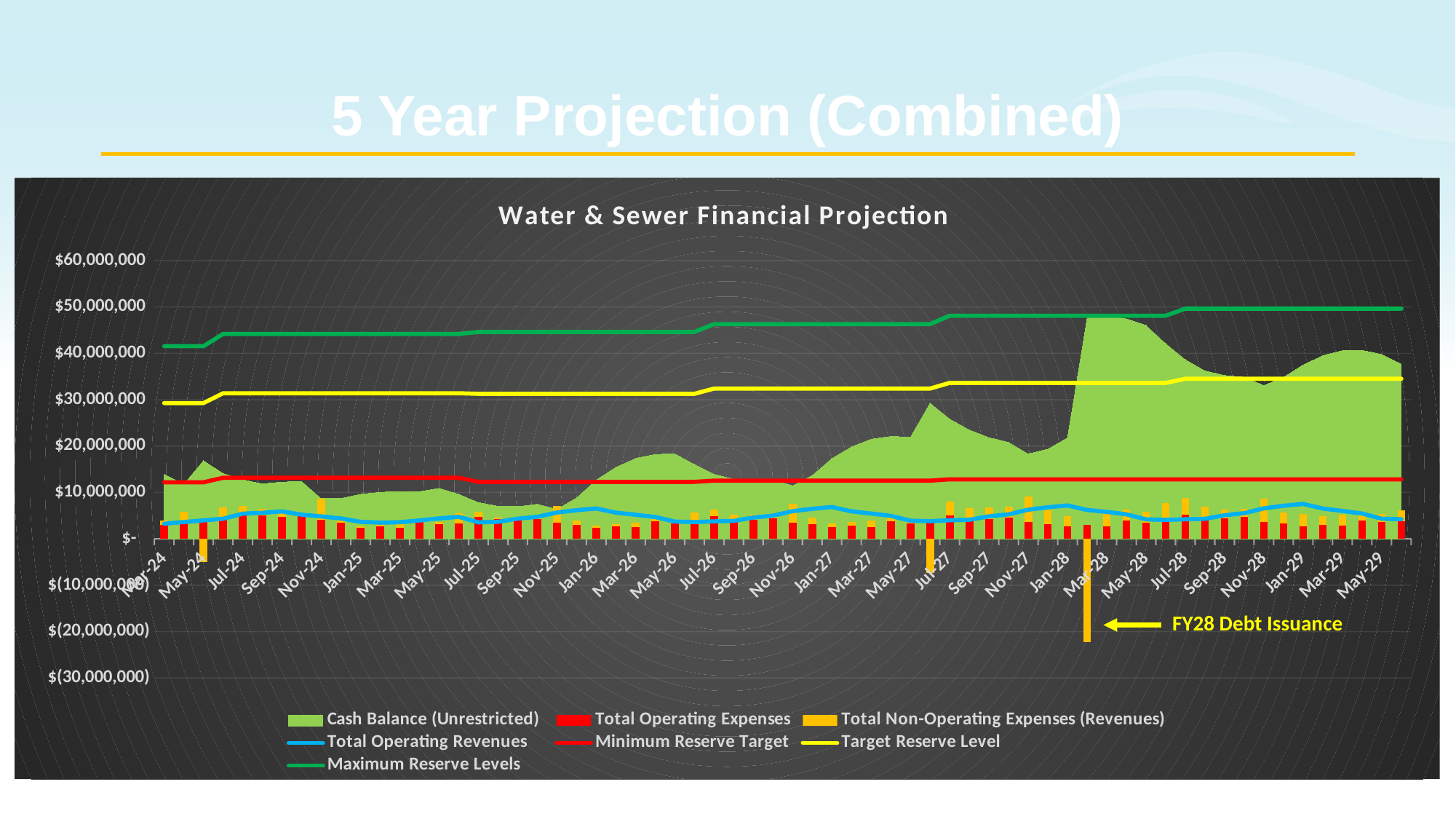
Is the Maximum Reserve Levels value at May-29 greater or less than $40,000,000? greater Is the Cash Balance (Unrestricted) at Nov-25 greater or less than $10,000,000? less Which series has the highest values throughout the chart? Maximum Reserve Levels Does the Maximum Reserve Levels line rise or fall from Mar-24 to May-29? rise What is the title of the chart on the slide? Water & Sewer Financial Projection Is the Minimum Reserve Target at Mar-24 greater or less than $10,000,000? greater What event does the annotation with the yellow arrow label in the chart? FY28 Debt Issuance Which series is shown as a green shaded area in the chart? Cash Balance (Unrestricted) How many series does the chart legend list? 7 Which is larger at Jan-27: the Target Reserve Level or the Minimum Reserve Target? Target Reserve Level In which year does the Cash Balance (Unrestricted) reach its highest point? 2028